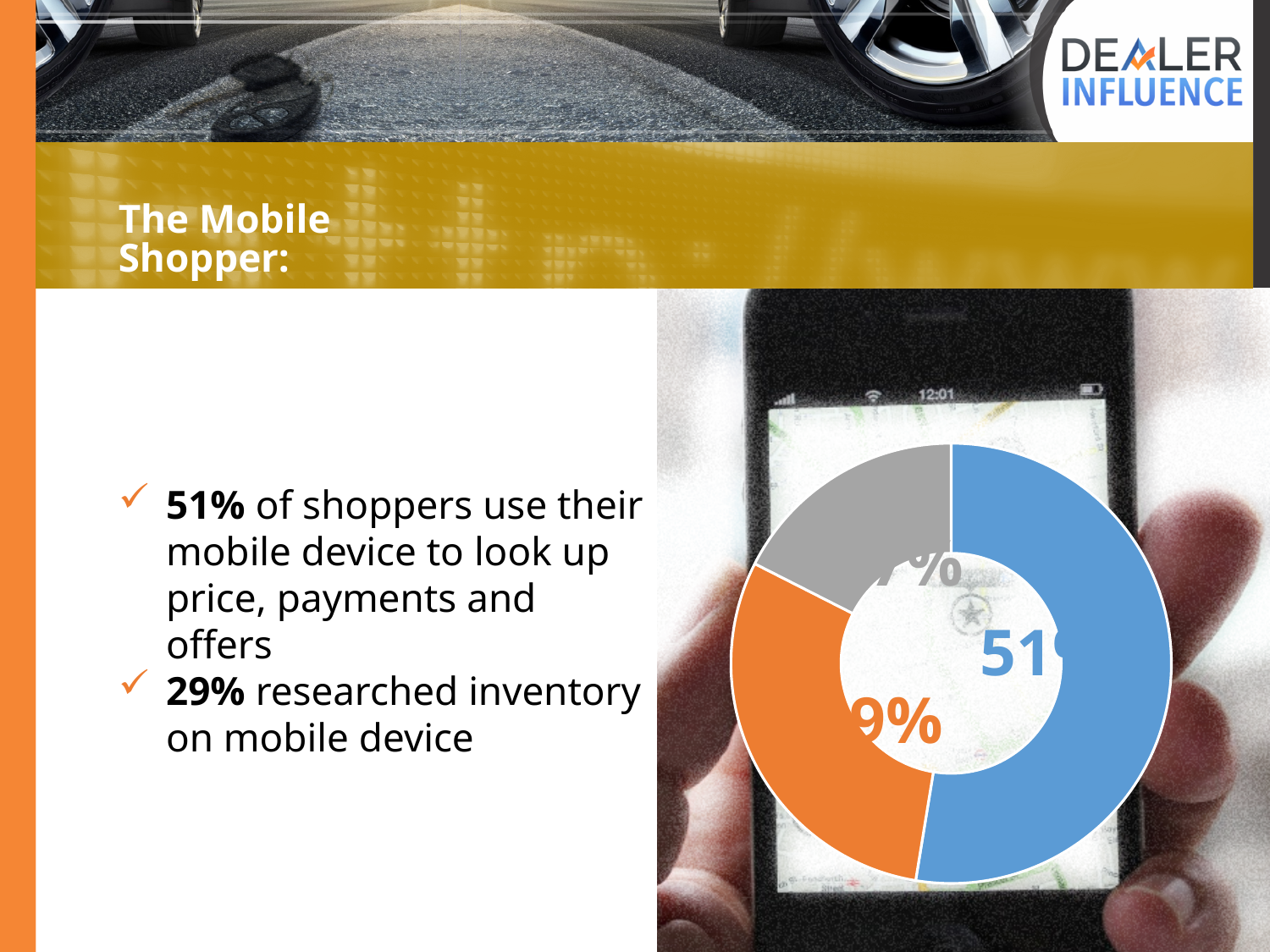
What is the difference between the blue slice and the orange slice in the doughnut chart? 22% Does the blue slice of the doughnut chart represent more or less than half of the total? More Which slice is larger in the doughnut chart, the orange one or the gray one? Orange What three colours are used for the slices of the doughnut chart? Blue, orange and gray Which colour slice is the largest in the doughnut chart? Blue What percentage does the blue slice of the doughnut chart represent? 51% Which slice is larger in the doughnut chart, the blue one or the orange one? Blue How many slices does the doughnut chart have? 3 What percentage does the orange slice of the doughnut chart represent? 29% Which colour slice is the smallest in the doughnut chart? Gray What kind of chart is shown on the slide? Doughnut chart